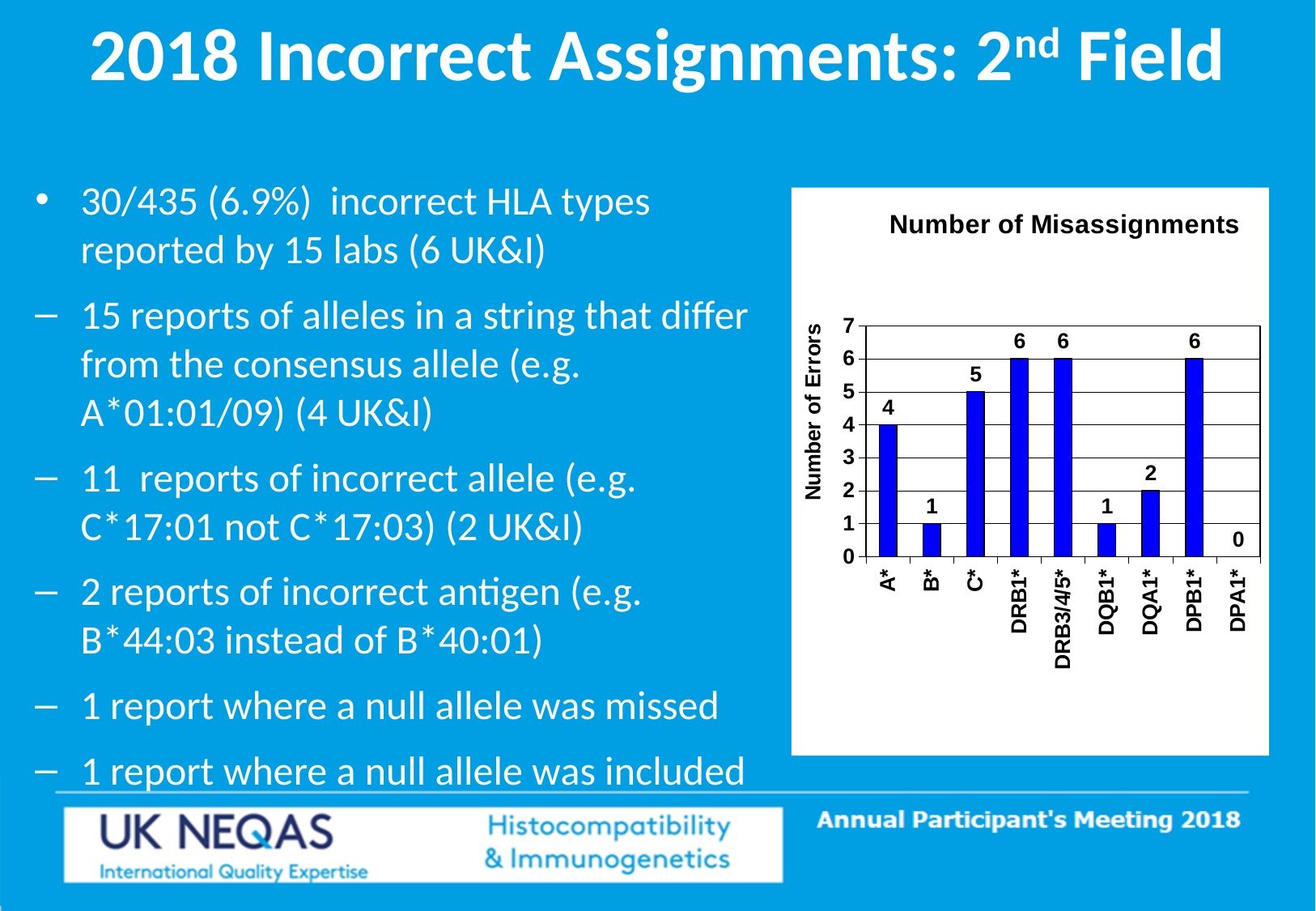
How many categories are shown on the x axis? 9 What kind of chart is shown? bar chart What is the difference in number of errors between DPB1* and DQA1*? 4 What is the number of errors for C*? 5 Which has more errors, A* or DQB1*? A* What is the difference in number of errors between DRB1* and B*? 5 Which category has the lowest number of errors? DPA1* What is the number of errors for DQA1*? 2 Which has more errors, C* or DQA1*? C* What is the label of the y axis? Number of Errors What is the number of errors for A*? 4 What is the title of the chart? Number of Misassignments